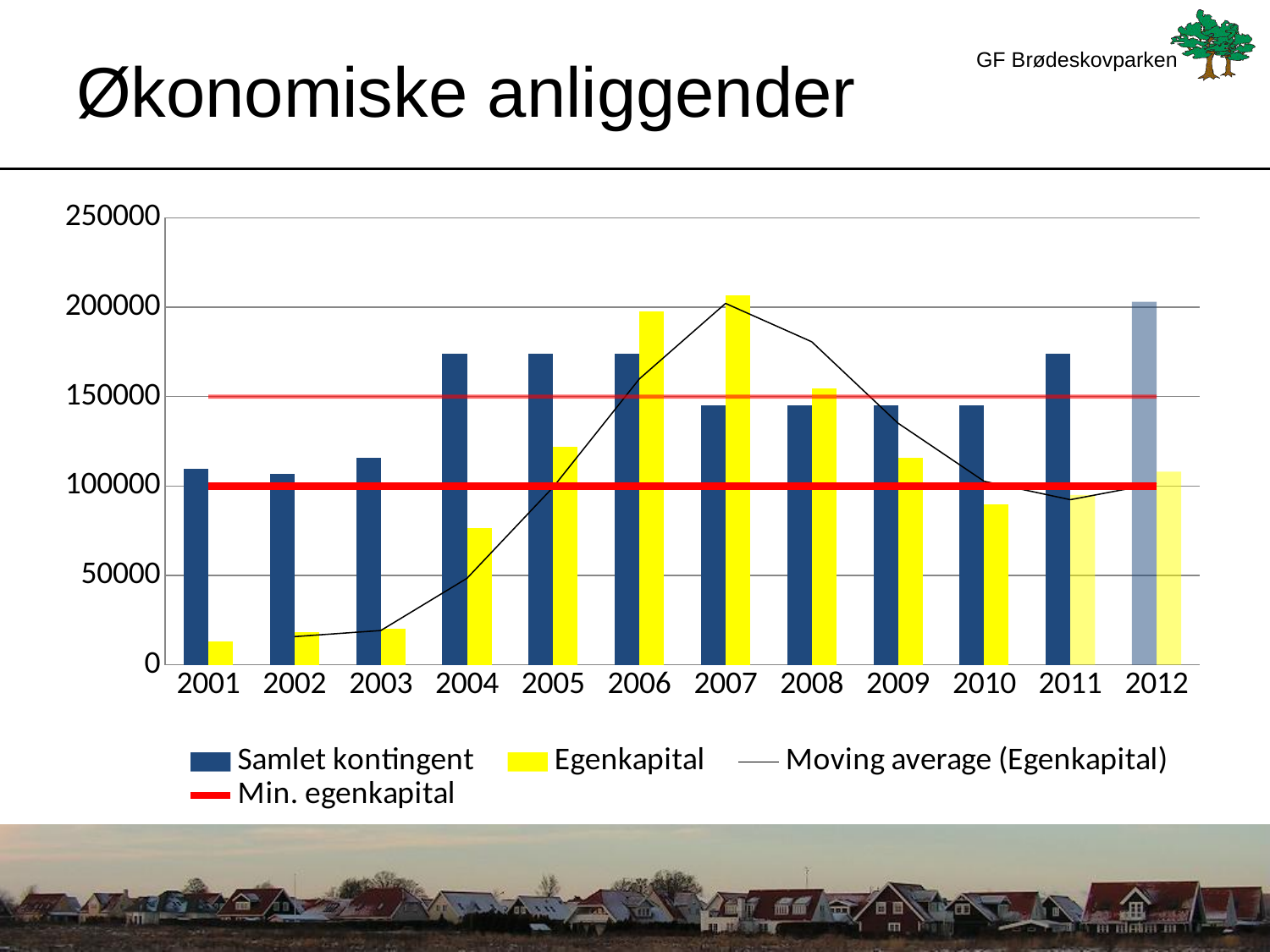
Is the value for Samlet kontingent in 2004 greater or less than 150000? greater In 2006, which is larger: Samlet kontingent or Egenkapital? Egenkapital In which year is Egenkapital highest? 2007 How many series does the legend list? 4 At what value is the Min. egenkapital line drawn? 100000 Is the value for Egenkapital in 2007 greater or less than 200000? greater What kind of chart is shown on the slide? Combination bar and line chart Is the value for Egenkapital in 2001 greater or less than 50000? less How many years are shown on the x axis of the chart? 12 In which year is Egenkapital lowest? 2001 Does Egenkapital rise or fall from 2007 to 2011? Fall In 2010, which is larger: Samlet kontingent or Egenkapital? Samlet kontingent